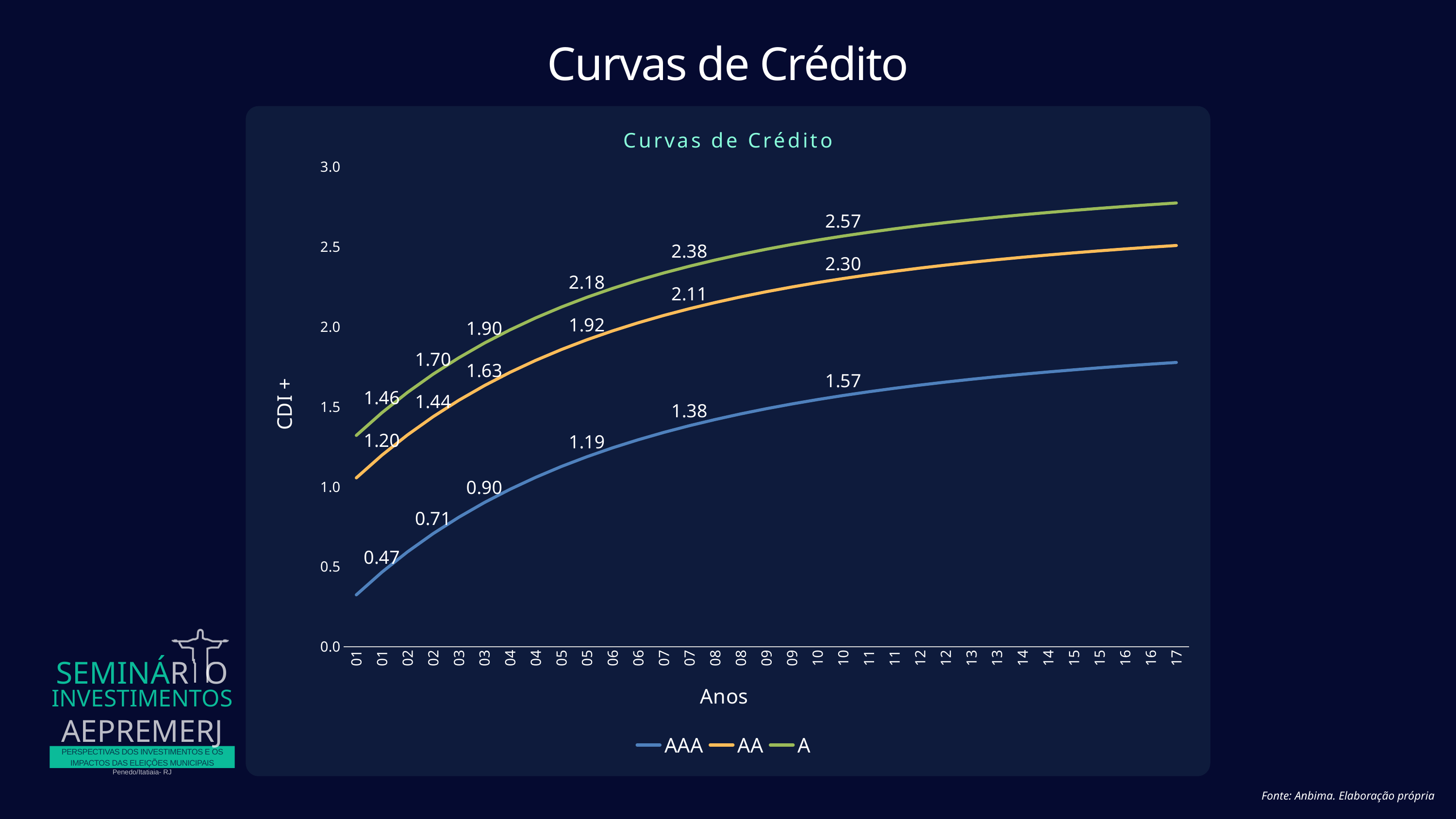
What is the title of the vertical axis? CDI + Which series has the highest values across the chart? A What is the highest data label shown for the A series? 2.57 What is the difference between the highest labelled value of the A series (2.57) and the highest labelled value of the AA series (2.30)? 0.27 What kind of chart is shown on the slide? line chart What is the first (leftmost) data label shown for the AA series? 1.20 Which is larger: the AA label 2.11 or the AAA label 1.38? AA (2.11) Do the values of the curves rise or fall as the years increase? rise What is the highest data label shown for the AAA series? 1.57 How many series does the legend list? 3 Is the value of the AAA series at year 17 greater or less than 1.5? greater Which series has the lowest values across the chart? AAA